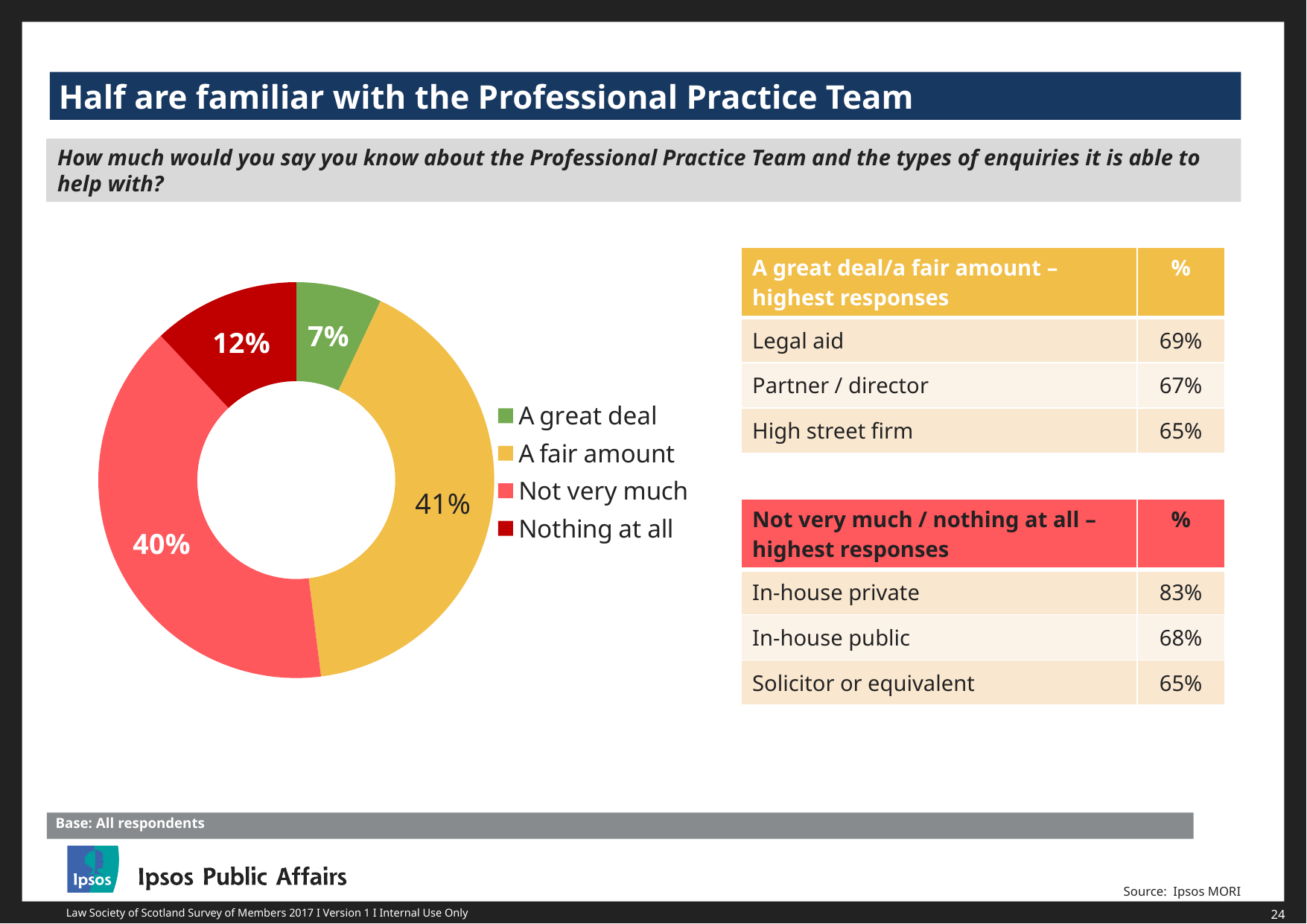
What percentage of respondents said 'A great deal'? 7% What colour represents 'Nothing at all' in the chart? Dark red What type of chart is used to show the responses? Donut chart How many response categories are shown in the donut chart? 4 What percentage of respondents said they know 'A fair amount' about the Professional Practice Team? 41% What is the combined percentage for 'A great deal' and 'A fair amount'? 48% How many entries does the chart legend list? 4 Which is larger: the share for 'A fair amount' or the share for 'Not very much'? A fair amount Which response category has the largest share of the donut chart? A fair amount What percentage of respondents said 'Nothing at all'? 12% What is the difference in percentage points between 'Not very much' and 'Nothing at all'? 28 Which response category has the smallest share of the donut chart? A great deal